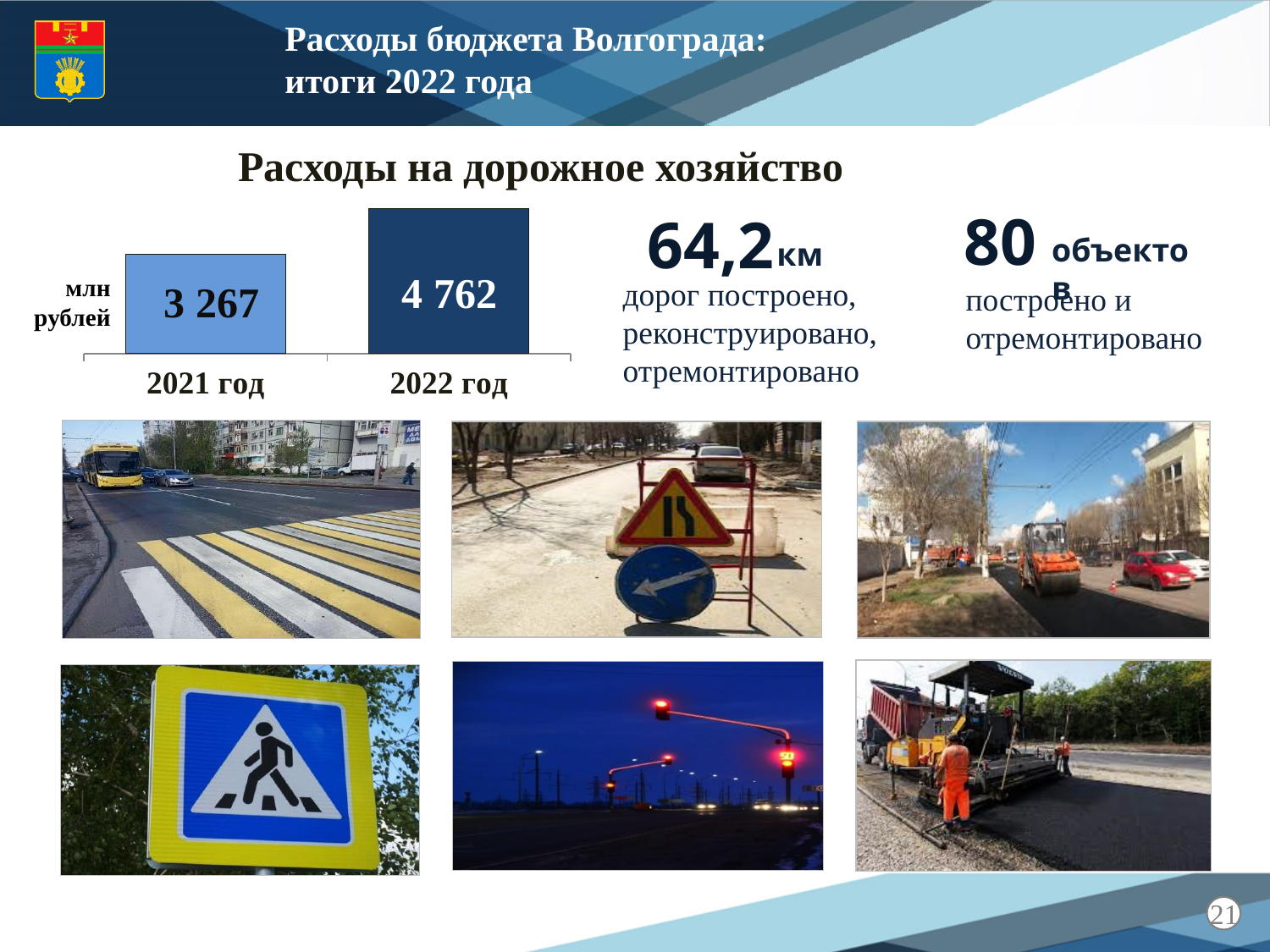
Which year has the lower value in the chart? 2021 год What is the value for 2022 год in the chart? 4 762 What kind of chart is shown on the slide? bar chart Is the value for 2022 год larger or smaller than the value for 2021 год? larger What is the difference between the 2022 год and 2021 год values in the chart? 1 495 Do the values rise or fall from 2021 год to 2022 год? rise What is the title above the chart? Расходы на дорожное хозяйство What unit is indicated for the values in the chart? млн рублей Which year has the higher value in the chart? 2022 год What is the value for 2021 год in the chart? 3 267 How many categories (years) are shown in the chart? 2